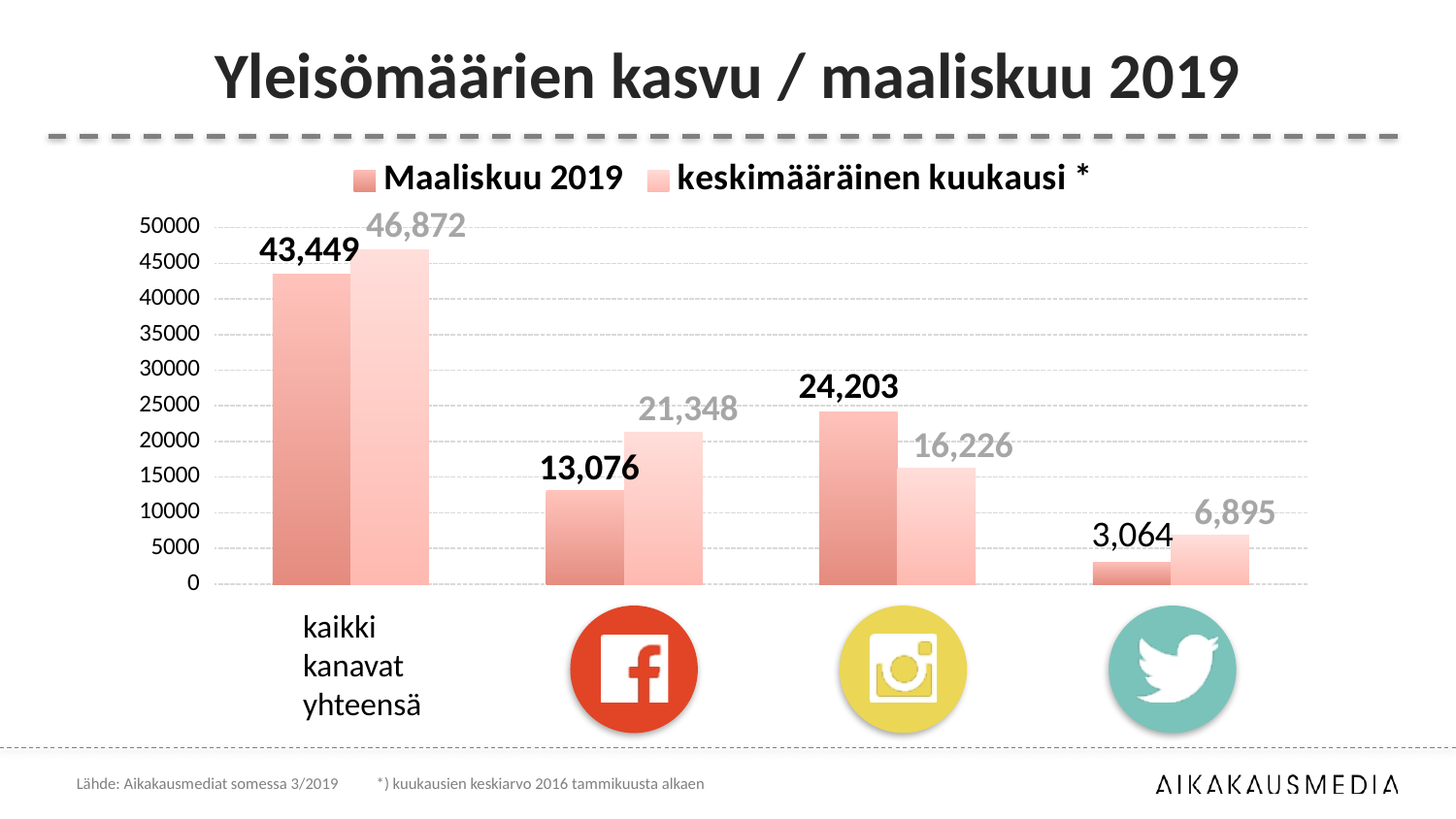
What is the value for "kaikki kanavat yhteensä" in the keskimääräinen kuukausi series? 46,872 What kind of chart is shown on the slide? Bar chart What is the Maaliskuu 2019 value for the Twitter category? 3,064 What is the Maaliskuu 2019 value for the Facebook category? 13,076 How many series does the legend list? 2 What is the value for "kaikki kanavat yhteensä" in the Maaliskuu 2019 series? 43,449 Among the individual channels (Facebook, Instagram, Twitter), which has the highest Maaliskuu 2019 value? Instagram For Instagram, which is larger: the Maaliskuu 2019 value or the keskimääräinen kuukausi value? Maaliskuu 2019 How many categories are shown on the x axis? 4 What is the keskimääräinen kuukausi value for the Instagram category? 16,226 What is the difference between the keskimääräinen kuukausi value and the Maaliskuu 2019 value for Facebook? 8,272 Which category has the lowest Maaliskuu 2019 value? Twitter